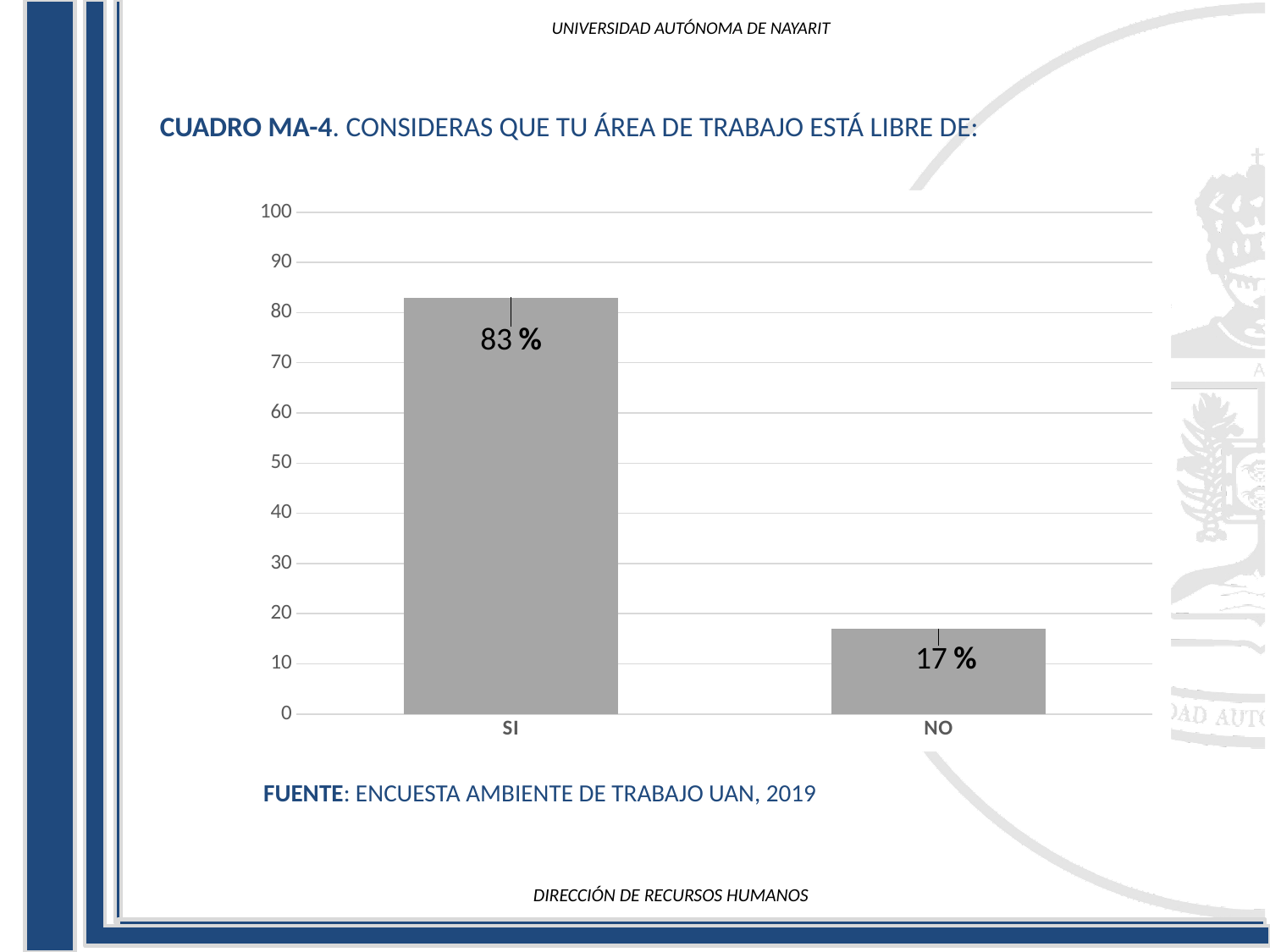
What is the source cited below the chart? ENCUESTA AMBIENTE DE TRABAJO UAN, 2019 What is the value for SI? 83 % Which is larger, the value for SI or the value for NO? SI What is the difference between the values for SI and NO? 66 % What is the total of the values for SI and NO? 100 % What is the value for NO? 17 % Is the value for SI greater or less than 80? greater Which category has the highest value? SI How many categories are shown on the x axis? 2 Is the value for NO greater or less than 20? less Which category has the lowest value? NO What kind of chart is shown on the slide? bar chart